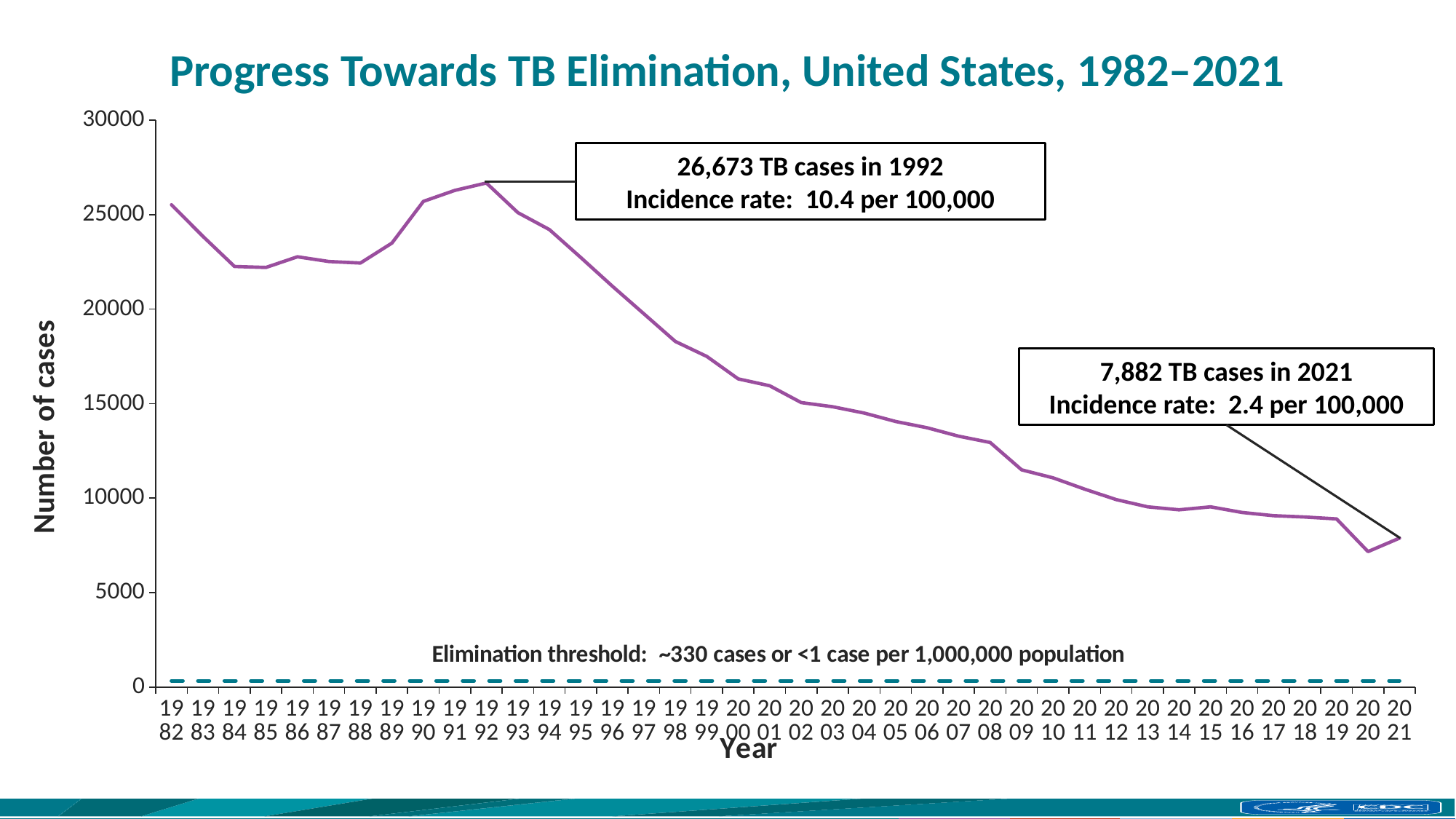
Is the number of cases in 1998 greater or less than 20000? less In which year does the number of TB cases reach its lowest point? 2020 Does the number of TB cases rise or fall from 1992 to 2021? Fall What is the difference between the number of TB cases in 1992 and in 2021? 18,791 How many TB cases were reported in 2021 according to the annotation? 7,882 How many TB cases were reported in 1992 according to the annotation? 26,673 Is the number of cases in 1984 greater or less than 20000? greater In which year does the number of TB cases reach its highest point? 1992 How many years are plotted on the x axis? 40 What was the TB incidence rate in 2021 according to the annotation? 2.4 per 100,000 What was the TB incidence rate in 1992 according to the annotation? 10.4 per 100,000 What type of chart is shown on the slide? Line chart